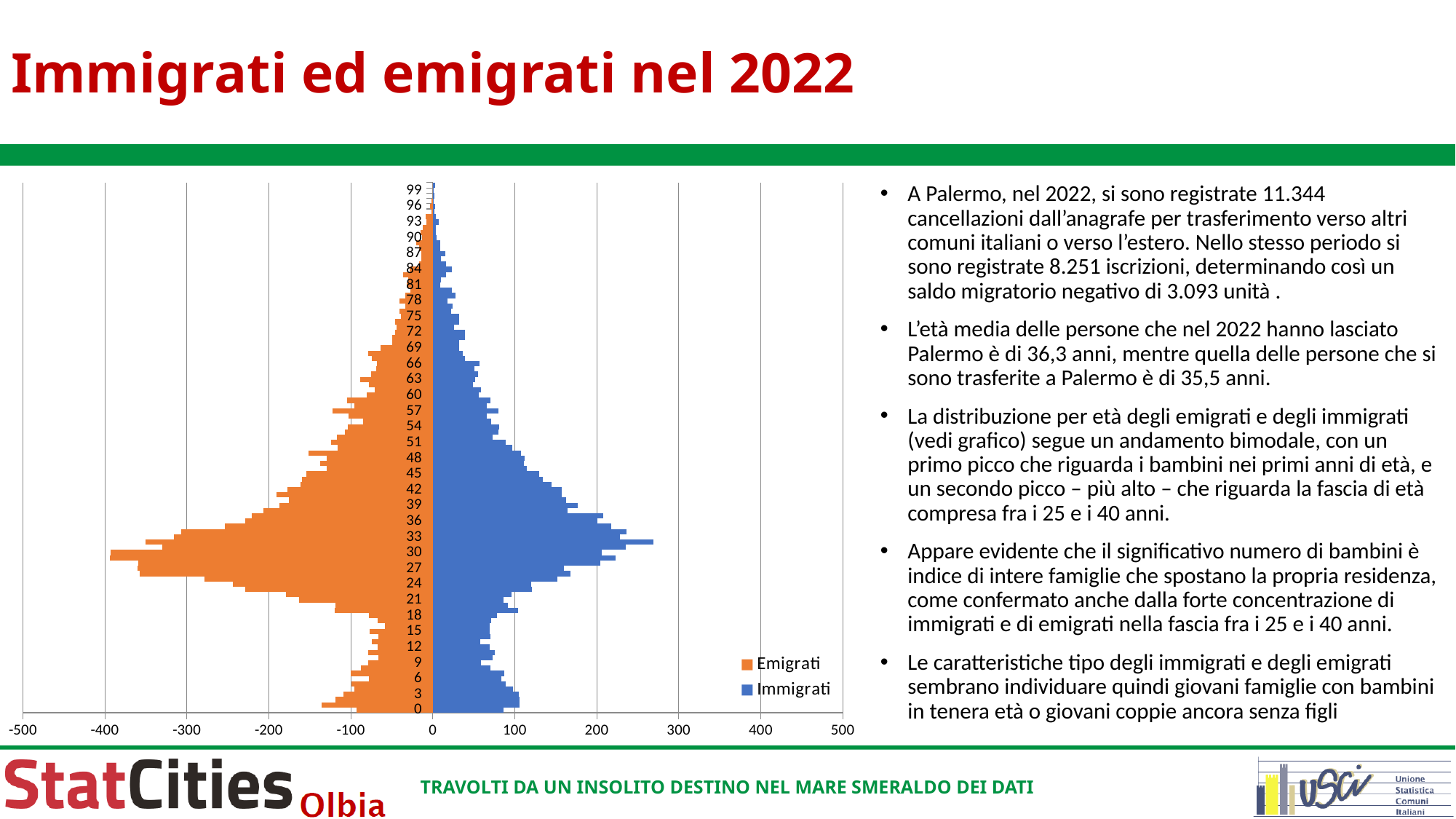
What is the highest age label shown on the vertical axis of the chart? 99 Which series has the longer bars overall, Emigrati or Immigrati? Emigrati Is the value for Emigrati at age 30 greater or less than -300? less Is the value for Immigrati at age 33 greater or less than 200? greater From age 60 up to age 99, do the Immigrati values rise or fall? fall Which two series are listed in the chart legend? Emigrati and Immigrati Which colour represents the Immigrati series in the chart? blue Is the value for Immigrati at age 90 greater or less than 100? less How many series does the chart legend list? 2 Is the Immigrati bar at age 33 longer or shorter than the Immigrati bar at age 60? longer What kind of chart is shown on the slide? bar chart